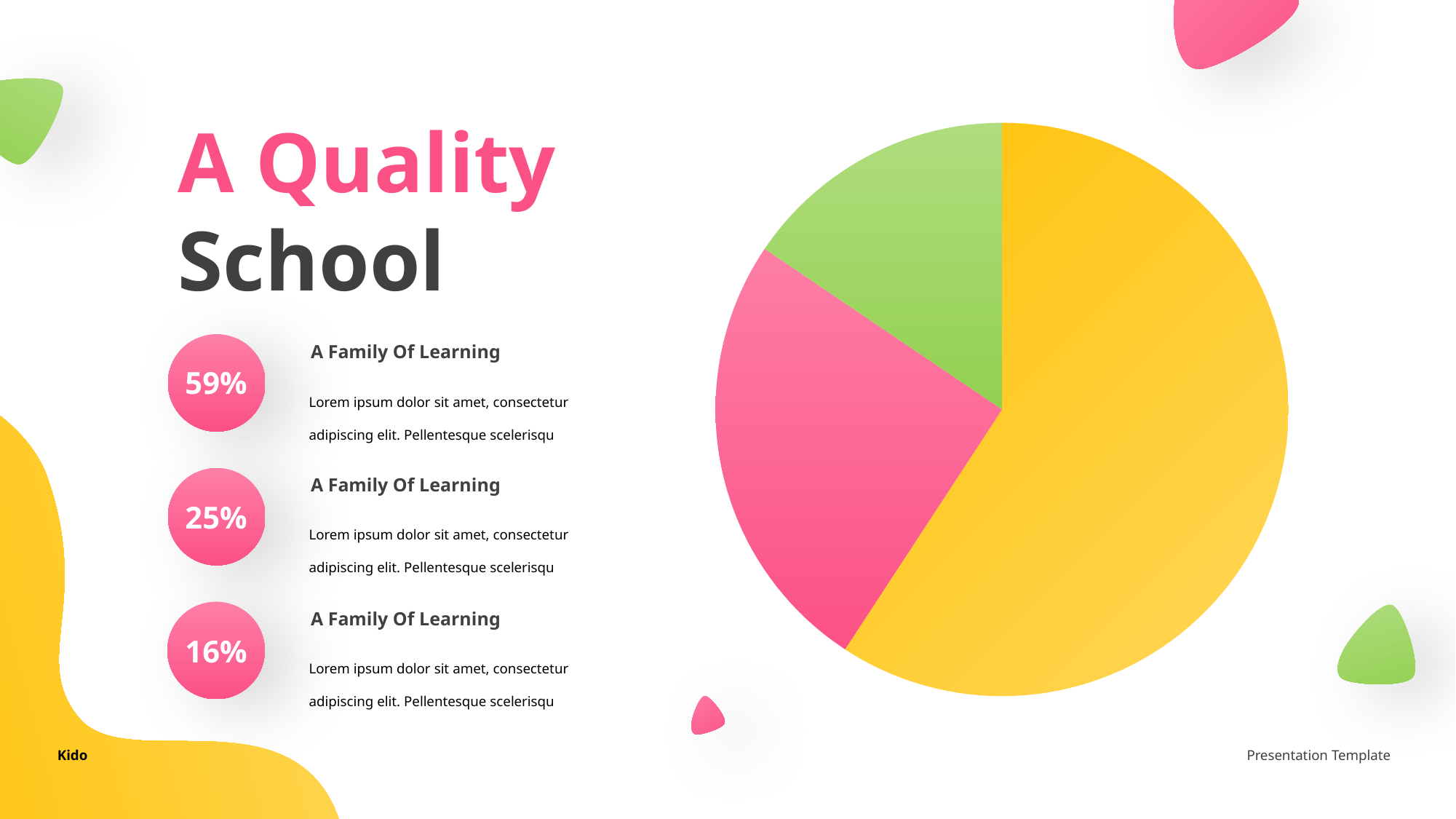
Does the yellow slice take up more or less than half of the pie chart? more What kind of chart is shown on the slide? pie chart What three colours are used for the slices of the pie chart? yellow, pink and green Is the pink slice or the green slice larger in the pie chart? pink Does the pie chart display a legend? No Which colour slice is the largest in the pie chart? yellow How many slices does the pie chart have? 3 Which colour slice is the smallest in the pie chart? green Is the yellow slice or the pink slice larger in the pie chart? yellow